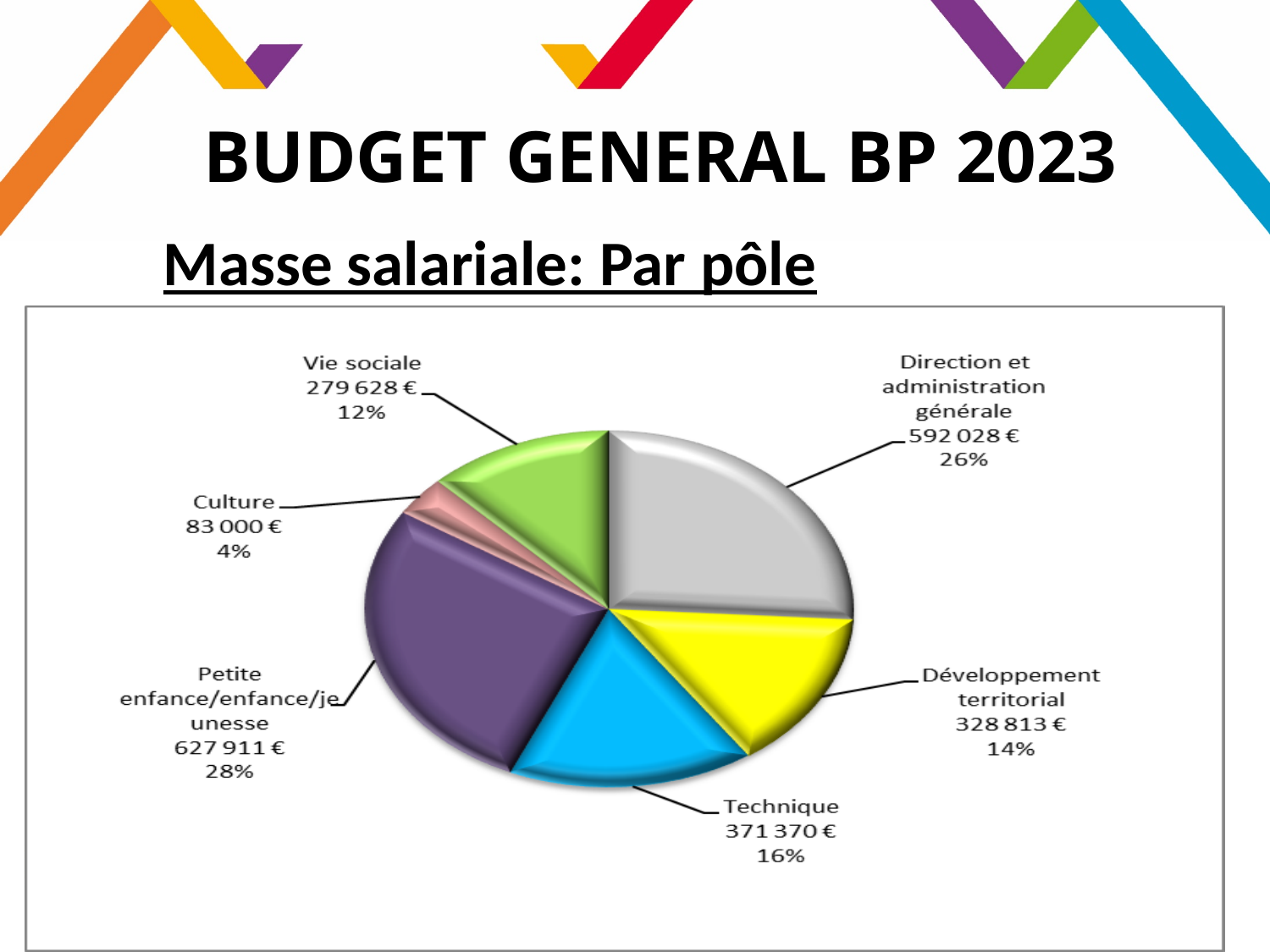
What kind of chart is shown on the slide? Pie chart What is the value for Technique in the pie chart? 371 370 € What is the value for Culture in the pie chart? 83 000 € What is the difference in euros between Petite enfance/enfance/jeunesse and Direction et administration générale? 35 883 € What percentage share does Vie sociale have in the pie chart? 12% What is the difference in euros between Vie sociale and Culture? 196 628 € How many pôles (slices) are shown in the pie chart? 6 What percentage share does Direction et administration générale have in the pie chart? 26% Which pôle has the smallest slice of the pie chart? Culture Which pôle has the largest slice of the pie chart? Petite enfance/enfance/jeunesse Which is larger, Technique or Développement territorial? Technique What is the subtitle of the chart on the slide? Masse salariale: Par pôle